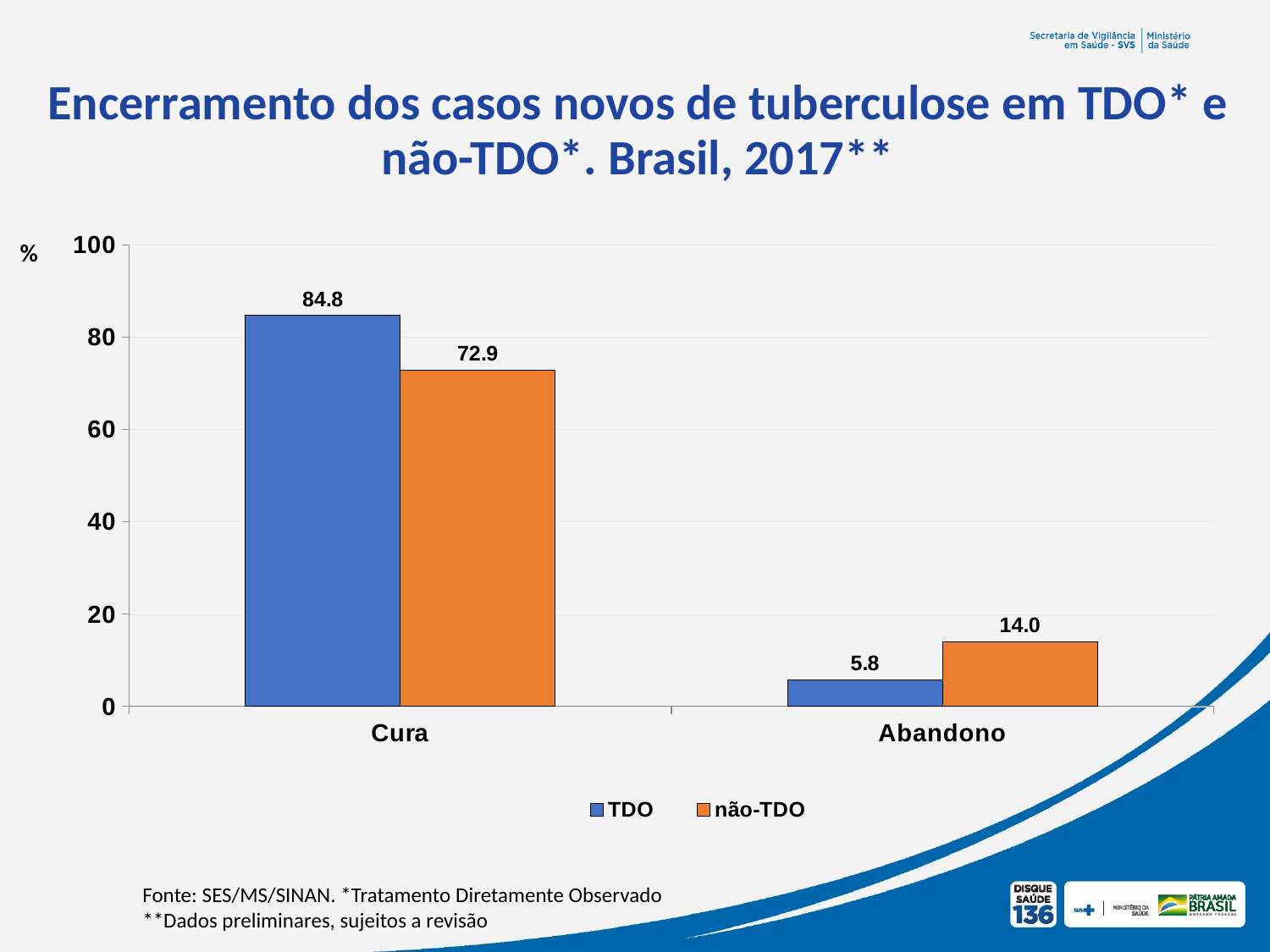
What is the difference between the TDO and não-TDO values in the Cura category? 11.9 What is the value for TDO in the Abandono category? 5.8 What is the value for não-TDO in the Abandono category? 14.0 How many series does the legend list? 2 Which series has the higher value in the Abandono category? não-TDO How many categories are shown on the x axis? 2 What kind of chart is shown on the slide? Bar chart What is the value for não-TDO in the Cura category? 72.9 What is the value for TDO in the Cura category? 84.8 Which colour represents the não-TDO series? Orange Which series has the higher value in the Cura category? TDO What is the difference between the não-TDO and TDO values in the Abandono category? 8.2